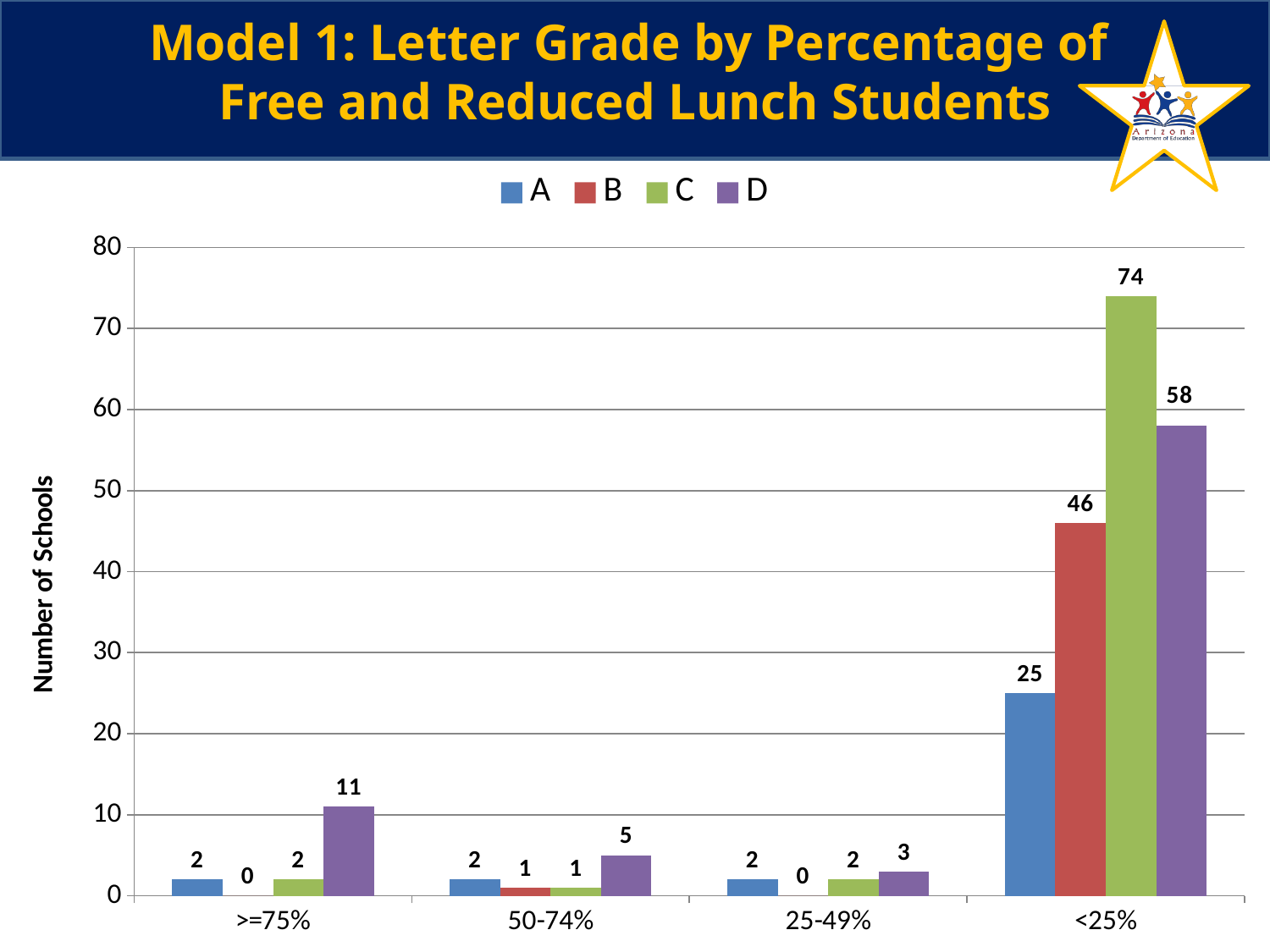
How many series does the legend list? 4 Which is larger in the <25% category: grade A or grade B? B How many schools with grade B are in the 50-74% category? 1 What is the label of the y axis? Number of Schools How many categories are shown on the x axis? 4 What is the value for grade D in the >=75% category? 11 Which letter grade has the lowest number of schools in the >=75% category? B How many schools with grade C are in the <25% category? 74 What is the total number of schools across all four grades in the <25% category? 203 Which letter grade has the highest number of schools in the <25% category? C What kind of chart is shown on the slide? bar chart What is the difference between the C and D values in the <25% category? 16